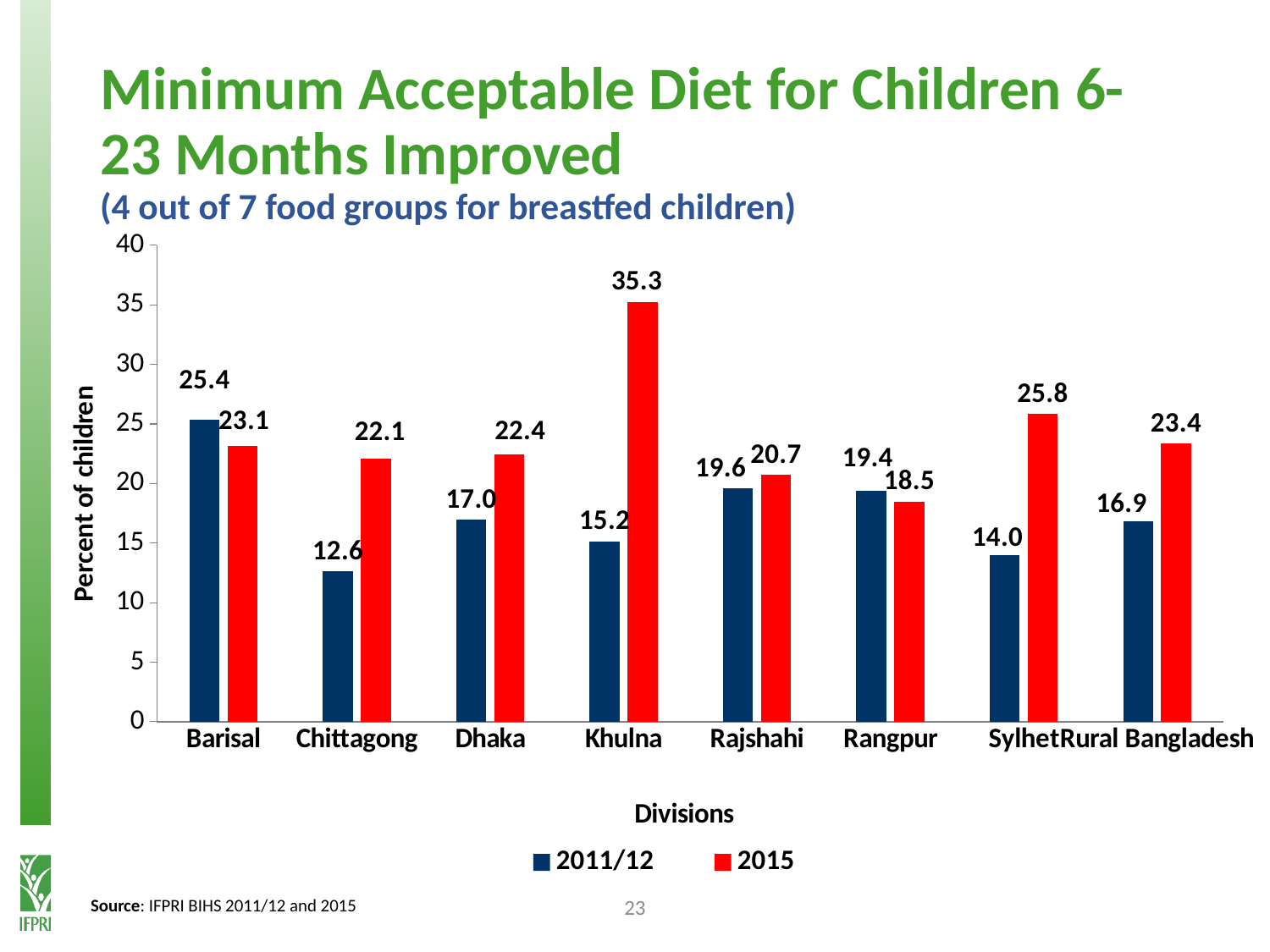
Which category has the lowest 2011/12 value? Chittagong How many categories are shown on the x axis? 8 What is the difference between the 2015 and 2011/12 values for Khulna? 20.1 What kind of chart is shown on the slide? Bar chart How many series does the legend list? 2 Which is larger for Rangpur, the 2011/12 value or the 2015 value? 2011/12 What is the 2015 value for Rural Bangladesh? 23.4 Which is larger for Sylhet, the 2011/12 value or the 2015 value? 2015 Which division has the highest 2015 value? Khulna What is the 2015 value for Khulna? 35.3 What is the 2011/12 value for Chittagong? 12.6 What is the label of the y axis? Percent of children